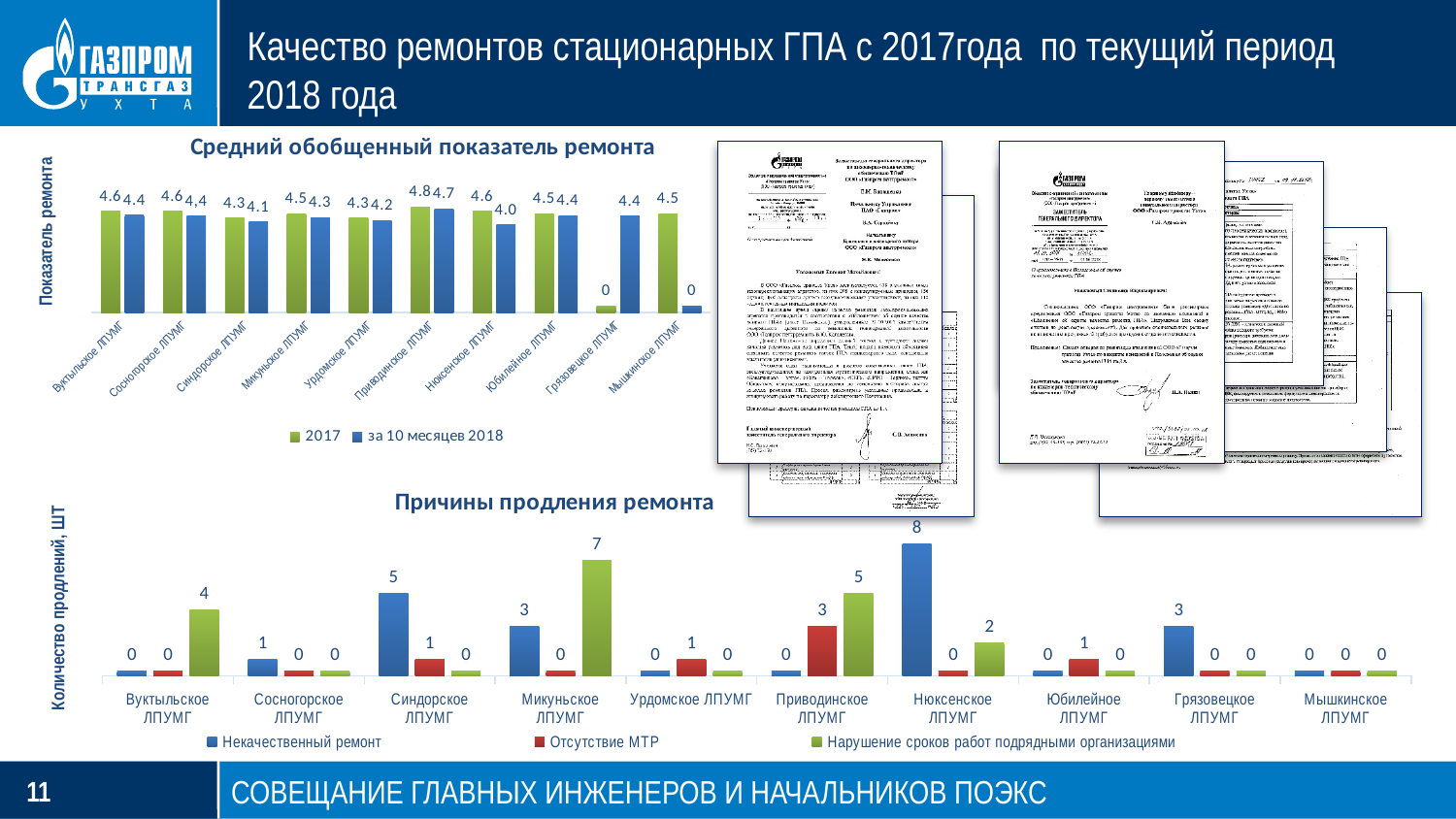
In the chart 'Причины продления ремонта', what is the value of 'Нарушение сроков работ подрядными организациями' for Микуньское ЛПУМГ? 7 In the chart 'Причины продления ремонта', which is larger for Синдорское ЛПУМГ: 'Некачественный ремонт' or 'Отсутствие МТР'? Некачественный ремонт In the chart 'Средний обобщенный показатель ремонта', how many categories are shown on the x axis? 10 In the chart 'Причины продления ремонта', how many series does the legend list? 3 In the chart 'Средний обобщенный показатель ремонта', what is the 'за 10 месяцев 2018' value for Нюксенское ЛПУМГ? 4.0 What type of chart is 'Причины продления ремонта'? Bar chart In the chart 'Средний обобщенный показатель ремонта', what is the difference between the 2017 and 'за 10 месяцев 2018' values for Нюксенское ЛПУМГ? 0.6 In the chart 'Причины продления ремонта', what is the value of 'Некачественный ремонт' for Нюксенское ЛПУМГ? 8 In the chart 'Средний обобщенный показатель ремонта', which category has the highest 2017 value? Приводинское ЛПУМГ In the chart 'Средний обобщенный показатель ремонта', what is the 2017 value for Приводинское ЛПУМГ? 4.8 In the chart 'Причины продления ремонта', which category has the highest value for 'Отсутствие МТР'? Приводинское ЛПУМГ In the chart 'Средний обобщенный показатель ремонта', how many series does the legend list? 2